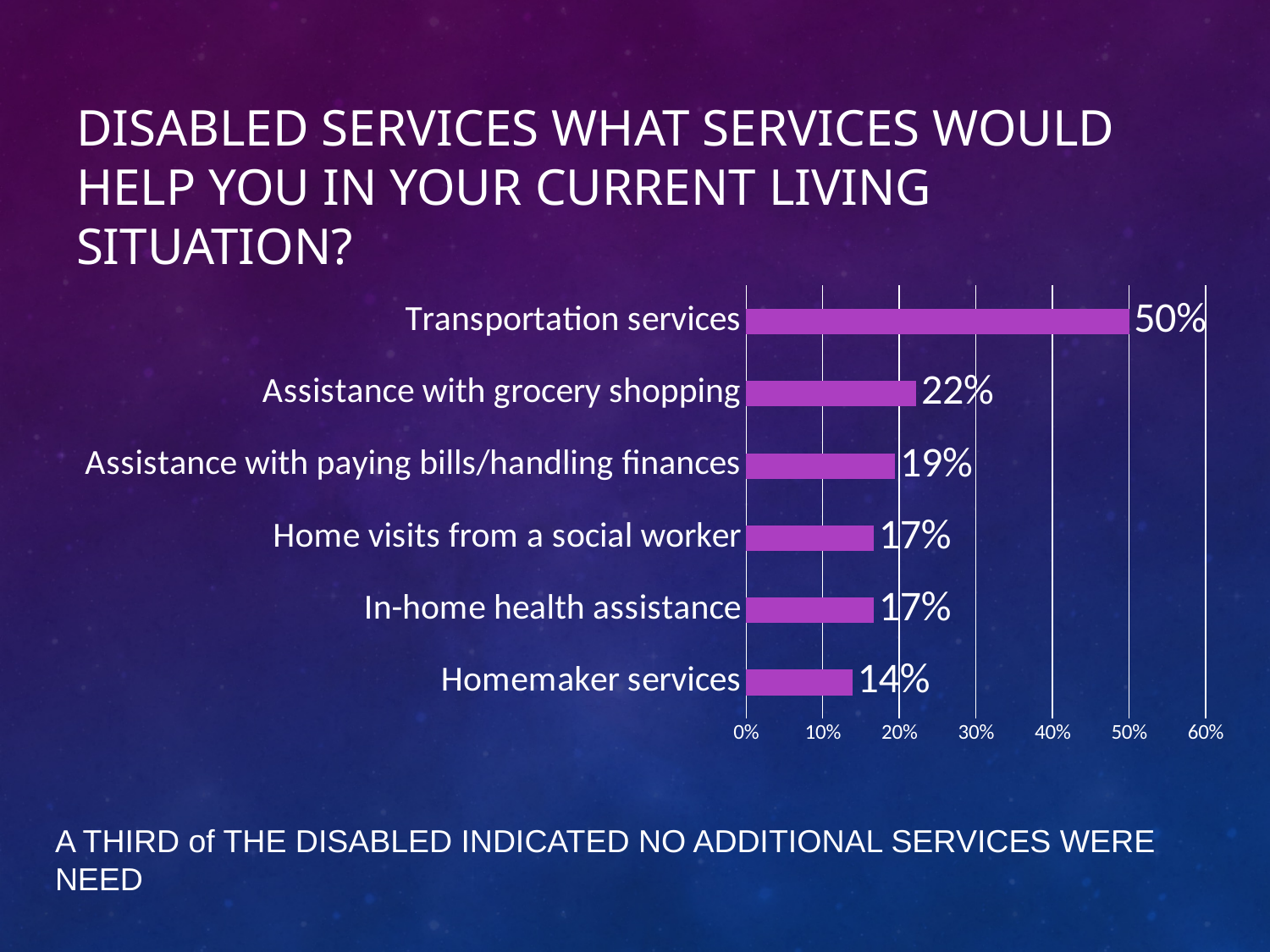
What kind of chart is shown on the slide? Bar chart What is the difference between the values for Assistance with paying bills/handling finances and Homemaker services? 5% Which category has the lowest value? Homemaker services What is the value for Homemaker services? 14% What is the difference between the values for Transportation services and Assistance with grocery shopping? 28% What is the highest value shown on the chart's axis? 60% What is the value for Assistance with paying bills/handling finances? 19% Which category has the highest value? Transportation services What is the value for Assistance with grocery shopping? 22% What is the value for Transportation services? 50% Which is larger, the value for Assistance with grocery shopping or the value for Home visits from a social worker? Assistance with grocery shopping How many categories are shown in the chart? 6